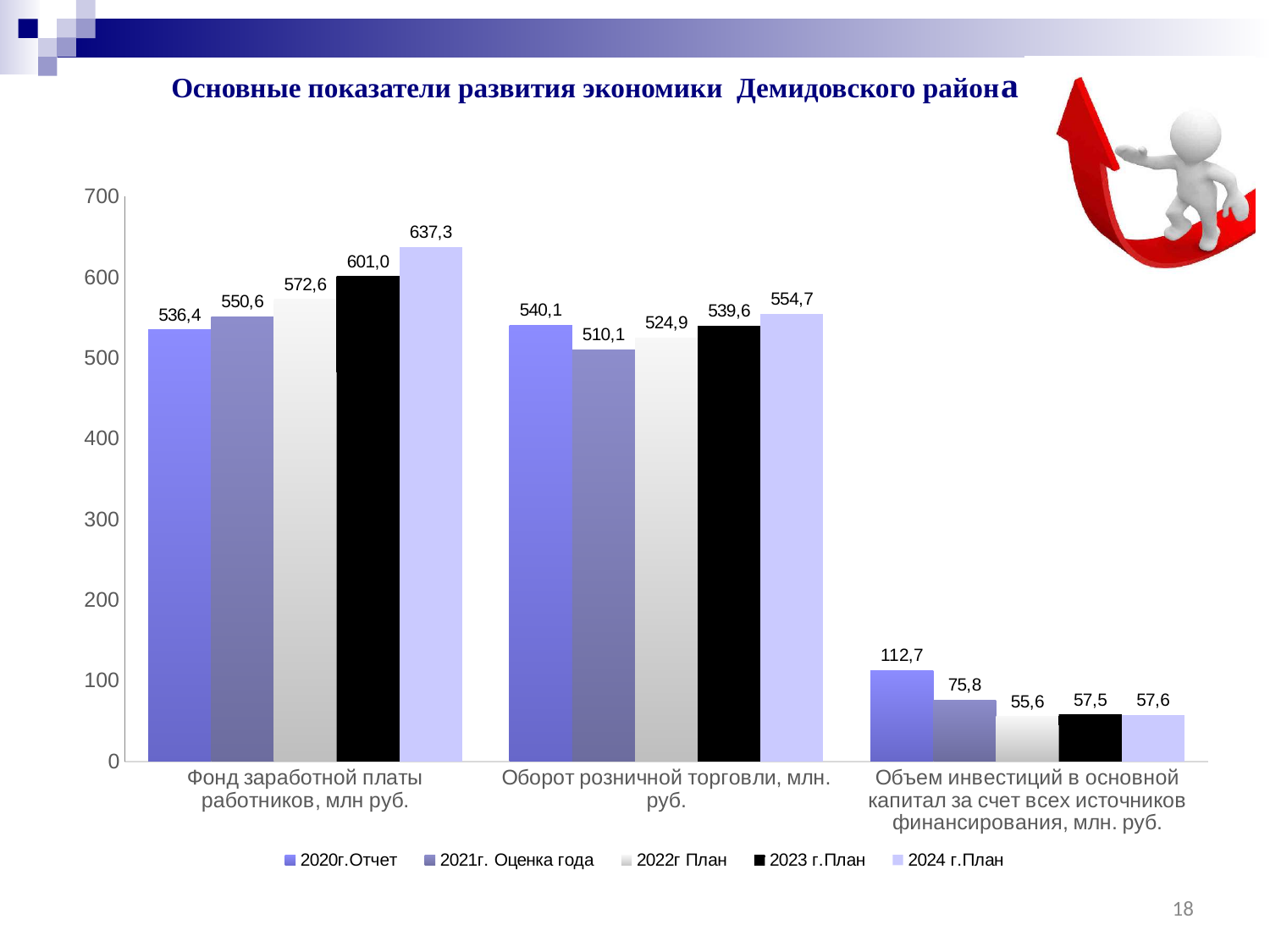
What is the value of 2021г. Оценка года for Оборот розничной торговли, млн. руб.? 510,1 Which is larger for 2021г. Оценка года: Фонд заработной платы работников, млн руб. or Оборот розничной торговли, млн. руб.? Фонд заработной платы работников, млн руб. What is the value of 2024 г.План for Фонд заработной платы работников, млн руб.? 637,3 What is the difference between the 2024 г.План and 2020г.Отчет values for Фонд заработной платы работников, млн руб.? 100,9 What is the value of 2020г.Отчет for Объем инвестиций в основной капитал за счет всех источников финансирования, млн. руб.? 112,7 How many categories are shown on the x axis? 3 Do the values for Фонд заработной платы работников, млн руб. rise or fall from 2020г.Отчет to 2024 г.План? rise What type of chart is shown on the slide? bar chart What is the difference between the 2020г.Отчет and 2021г. Оценка года values for Объем инвестиций в основной капитал за счет всех источников финансирования, млн. руб.? 36,9 Which series has the lowest value for Объем инвестиций в основной капитал за счет всех источников финансирования, млн. руб.? 2022г План Which series has the highest value for Фонд заработной платы работников, млн руб.? 2024 г.План How many series does the legend list? 5